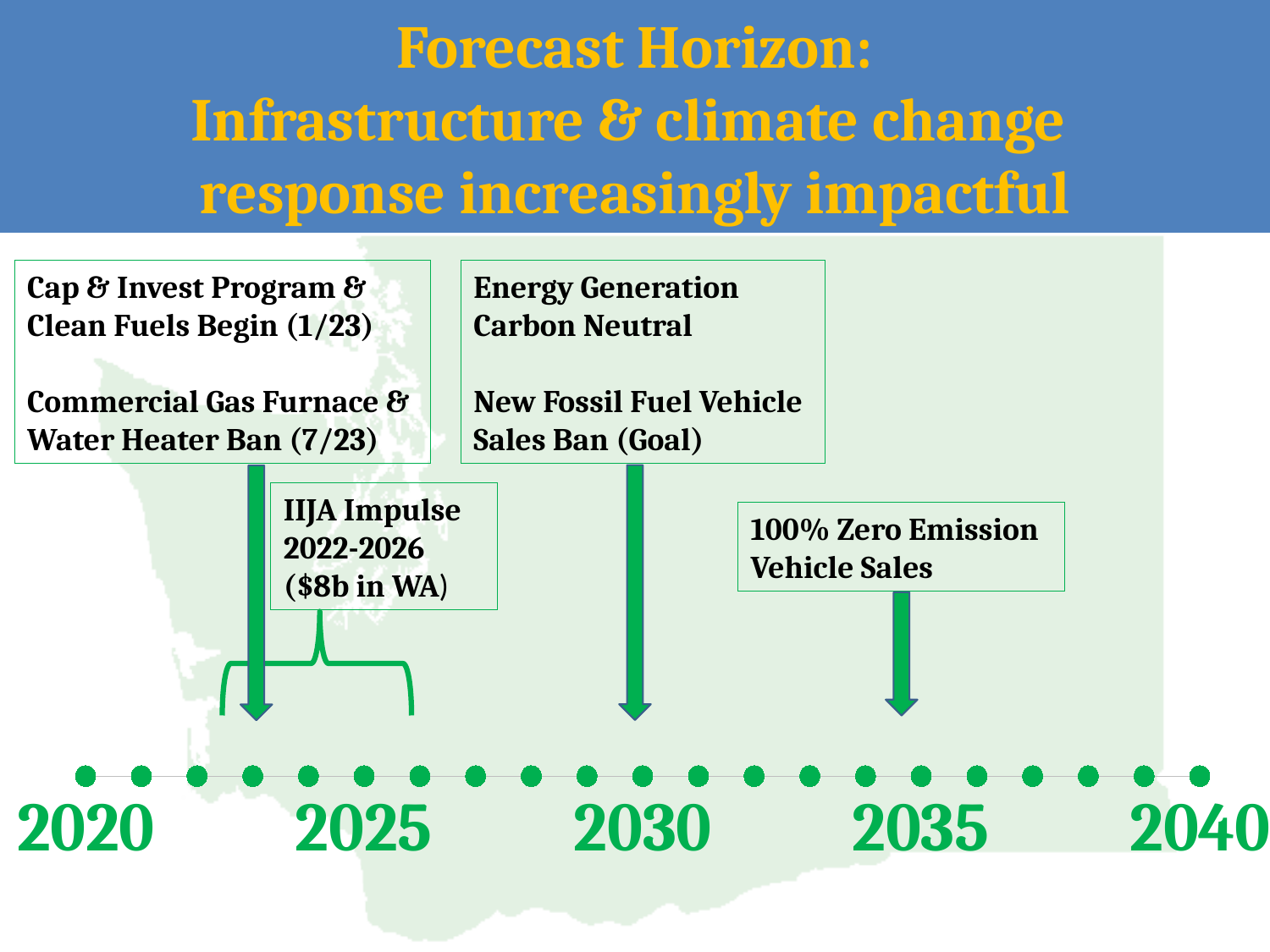
What is the first year labelled on the timeline axis? 2020 Which milestone comes later on the timeline: 'Energy Generation Carbon Neutral' or '100% Zero Emission Vehicle Sales'? 100% Zero Emission Vehicle Sales What kind of chart is shown on the slide? A timeline Over which years does the 'IIJA Impulse' span on the timeline? 2022-2026 How many years apart are the labelled tick marks on the timeline axis (e.g., 2020, 2025, 2030)? 5 Which year does the arrow for 'Energy Generation Carbon Neutral' and 'New Fossil Fuel Vehicle Sales Ban (Goal)' point to on the timeline? 2030 What is the last year labelled on the timeline axis? 2040 What dollar amount is given for the IIJA Impulse in WA? $8b When does the Commercial Gas Furnace & Water Heater Ban take effect according to the timeline? 7/23 Which year does the arrow for '100% Zero Emission Vehicle Sales' point to on the timeline? 2035 How many dots (year markers) are on the timeline? 21 In what month and year does the Cap & Invest Program & Clean Fuels begin according to the timeline? 1/23